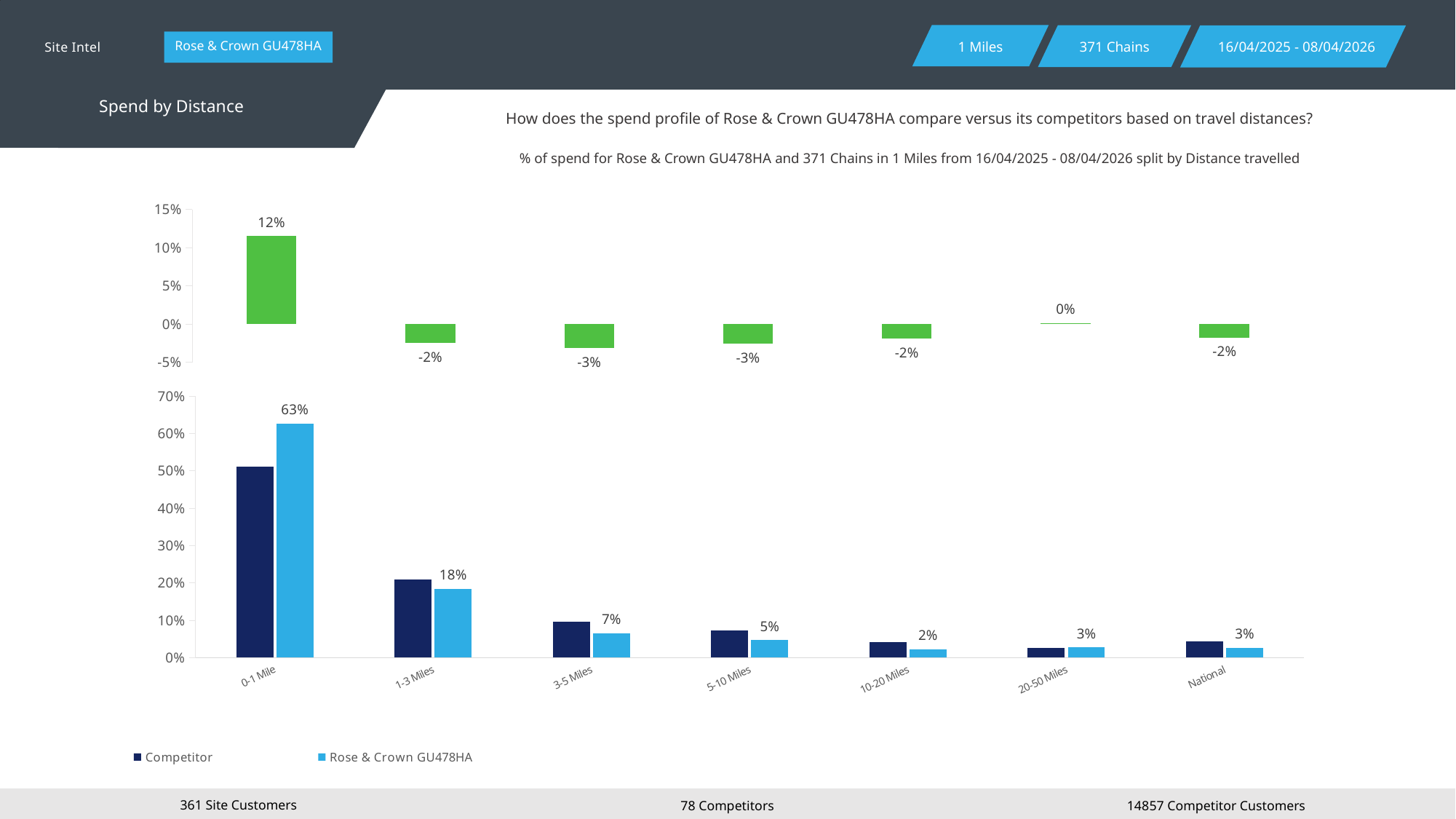
In the bottom chart, do the Rose & Crown GU478HA values rise or fall from 0-1 Mile to 10-20 Miles? fall What kind of chart is the bottom chart? bar chart In the bottom chart, at 0-1 Mile, which series has the larger value: Competitor or Rose & Crown GU478HA? Rose & Crown GU478HA How many series does the legend of the bottom chart list? 2 In the bottom chart, is the Competitor value for 0-1 Mile greater or less than 60%? less In the bottom chart, which distance category has the highest value for Rose & Crown GU478HA? 0-1 Mile In the top chart, what is the value shown for 0-1 Mile? 12% In the bottom chart, what is the value for Rose & Crown GU478HA at 3-5 Miles? 7% In the top chart, which distance category has the highest value? 0-1 Mile How many distance categories are shown on the x axis of the bottom chart? 7 In the bottom chart, what is the difference between the Rose & Crown GU478HA values for 0-1 Mile and 1-3 Miles? 45% In the bottom chart, what is the value for Rose & Crown GU478HA at 0-1 Mile? 63%